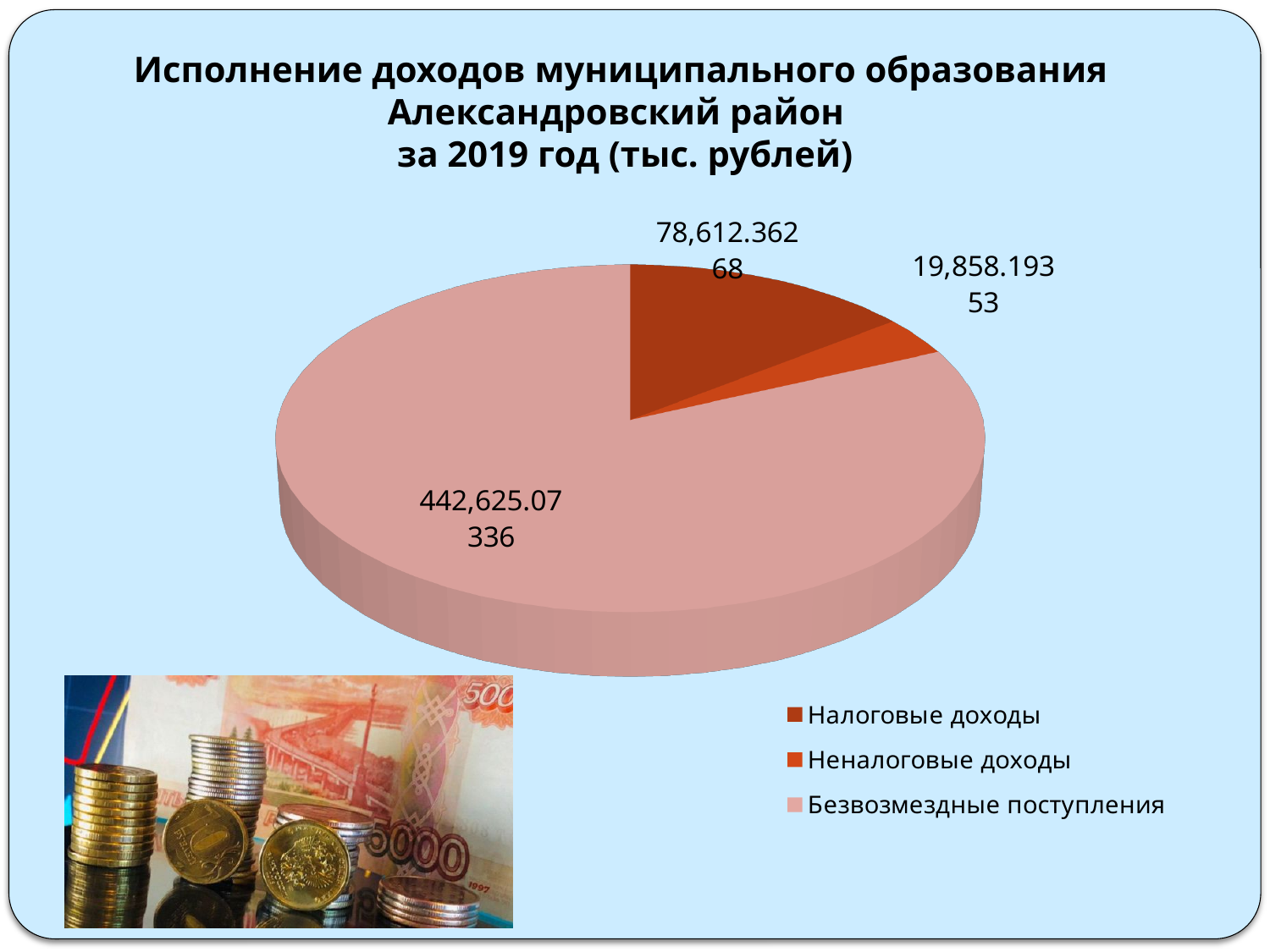
What is the value shown for Неналоговые доходы? 19,858.19353 What is the value shown for Безвозмездные поступления? 442,625.07336 What is the total of all three slices of the pie? 541,095.62957 In what units are the values on the chart given, according to the title? тыс. рублей What is the value shown for Налоговые доходы? 78,612.36268 How many entries does the legend list? 3 Which is larger, Налоговые доходы or Неналоговые доходы? Налоговые доходы How many slices does the pie chart have? 3 What is the difference between the values for Налоговые доходы and Неналоговые доходы? 58,754.16915 What kind of chart is shown on the slide? Pie chart Which category has the largest slice of the pie? Безвозмездные поступления Which category has the smallest slice of the pie? Неналоговые доходы